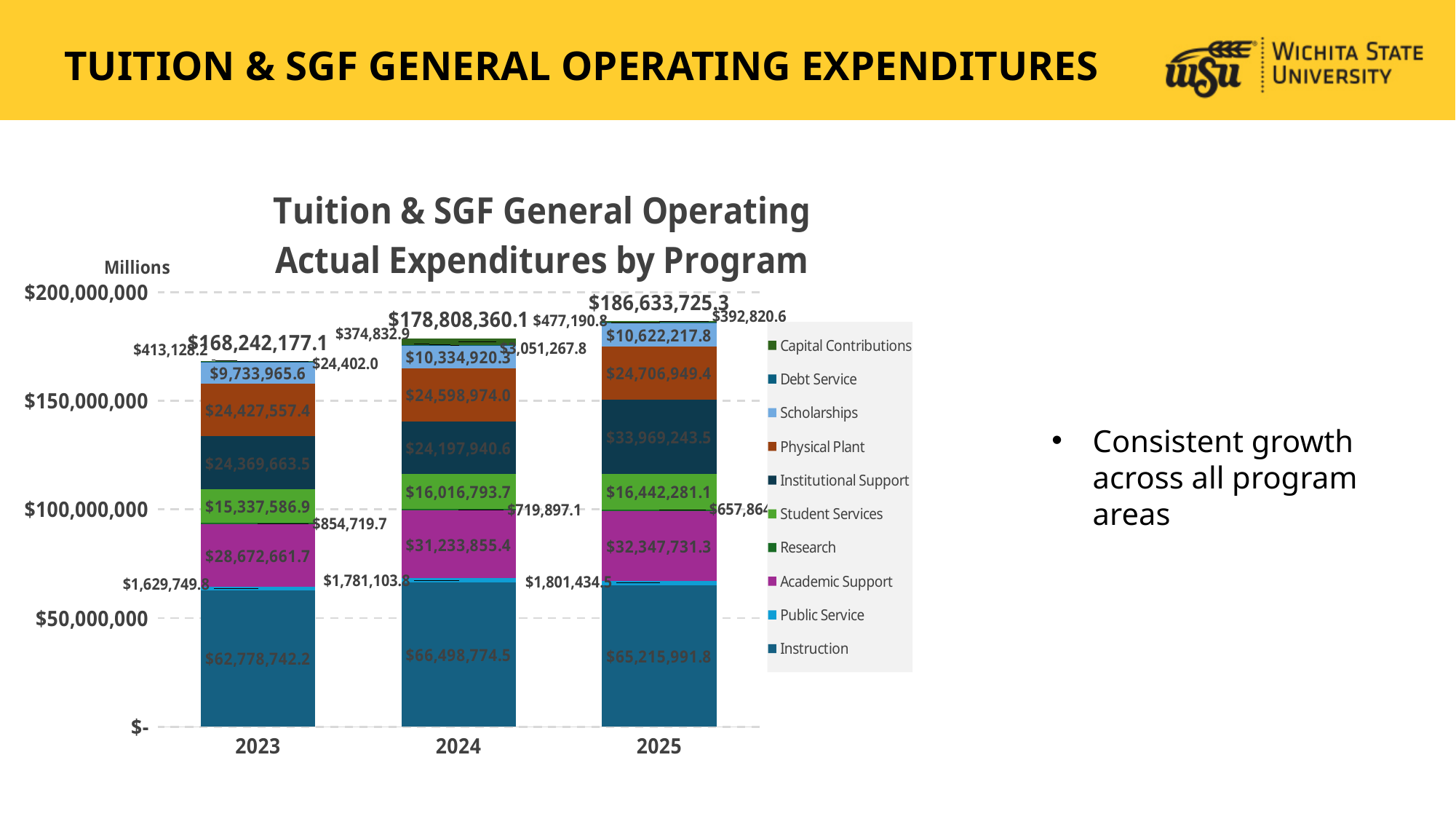
What is the total expenditure shown above the 2025 bar? $186,633,725.3 Which year has the larger Instruction value, 2024 or 2025? 2024 How many series does the chart legend list? 10 What is the title of the chart? Tuition & SGF General Operating Actual Expenditures by Program What is the Instruction value for 2024? $66,498,774.5 Do the total expenditures rise or fall from 2023 to 2025? Rise What is the Institutional Support value for 2025? $33,969,243.5 What is the difference between the 2025 total and the 2023 total? $18,391,548.2 Which year has the highest total expenditure? 2025 How many years are shown on the x axis of the chart? 3 What is the total expenditure shown above the 2023 bar? $168,242,177.1 What kind of chart is shown on the slide? Stacked bar chart